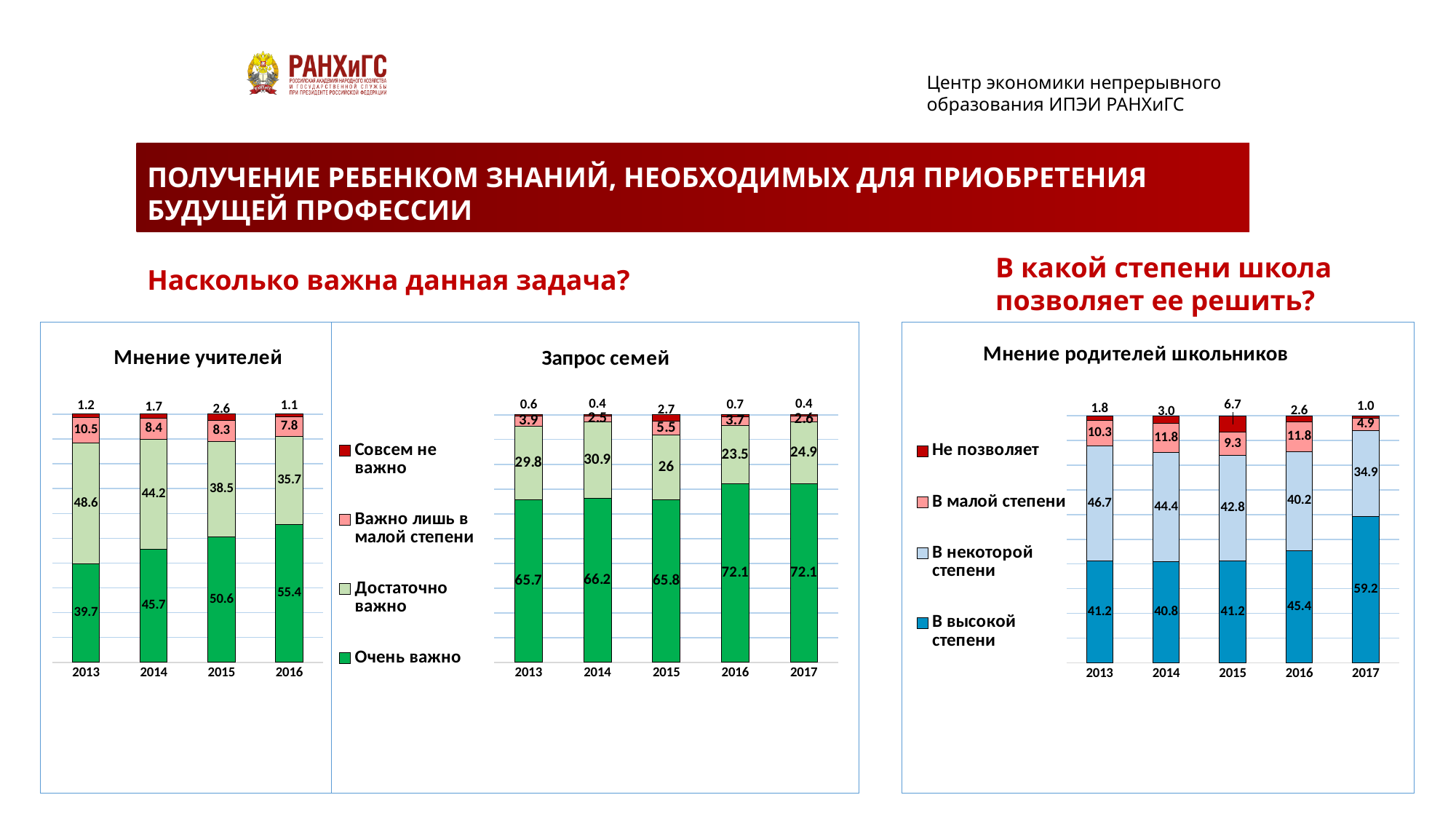
In the "Мнение родителей школьников" chart, which year has the lowest value for "В некоторой степени"? 2017 In the "Мнение учителей" chart, what is the difference between the "Достаточно важно" values for 2013 and 2016? 12.9 How many series does the legend of the "Мнение родителей школьников" chart list? 4 In the "Запрос семей" chart, what is the value for "Очень важно" in 2017? 72.1 What kind of chart is the "Мнение родителей школьников" chart? stacked bar chart In the "Запрос семей" chart, which is larger: the "Достаточно важно" value in 2014 or in 2017? 2014 In the "Мнение учителей" chart, what is the value for "Очень важно" in 2016? 55.4 In the "Запрос семей" chart, how many years are shown on the x axis? 5 In the "Мнение учителей" chart, which year has the highest value for "Очень важно"? 2016 In the "Запрос семей" chart, which year has the highest value for "Совсем не важно"? 2015 In the "Мнение учителей" chart, does the "Очень важно" value rise or fall from 2013 to 2016? rise In the "Мнение родителей школьников" chart, what is the value for "В высокой степени" in 2017? 59.2